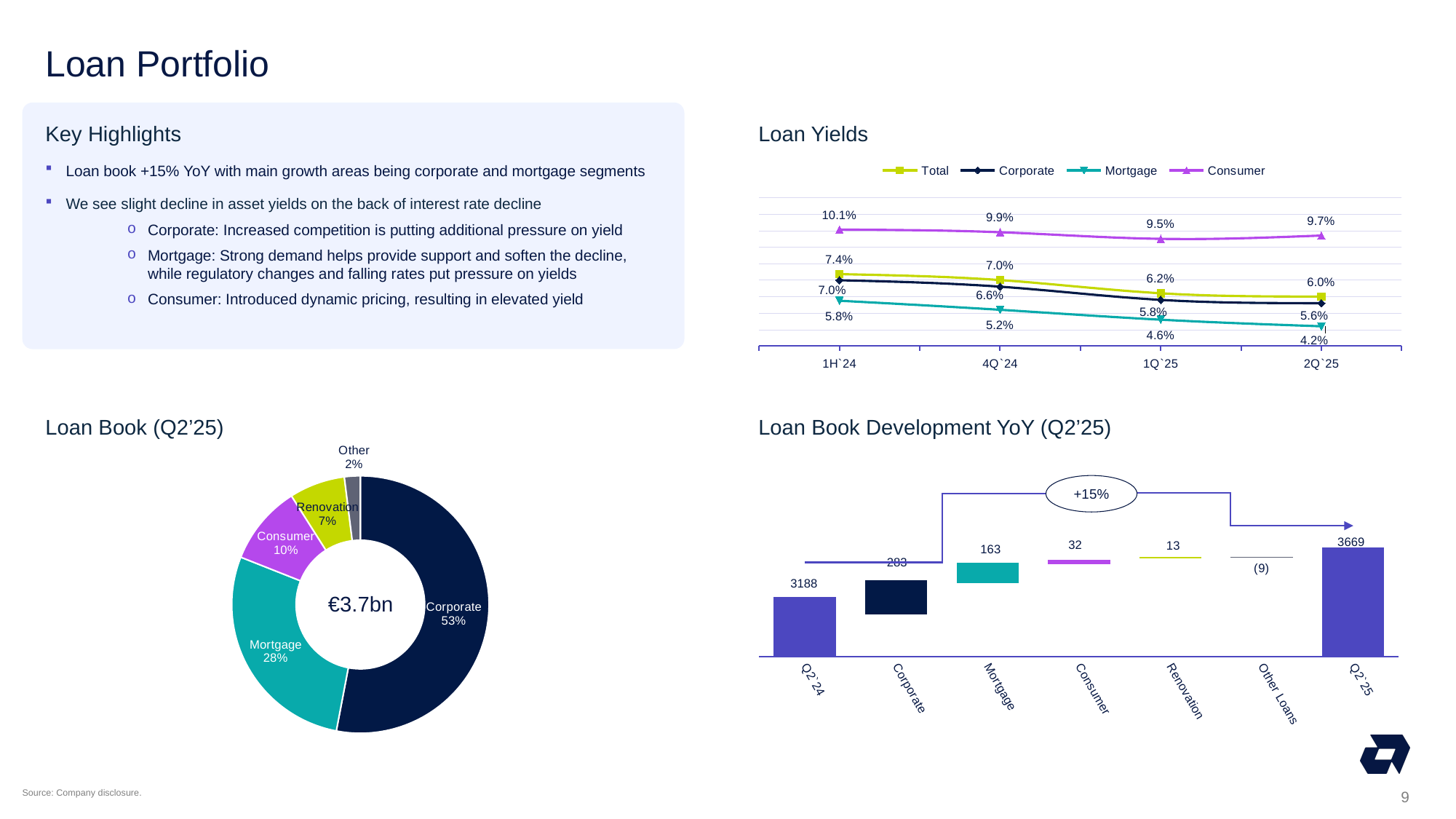
In the Loan Yields chart, how many series does the legend list? 4 In the Loan Yields chart, what is the Consumer yield in 1H`24? 10.1% In the Loan Book (Q2'25) chart, which segment has the smallest share? Other In the Loan Yields chart, which series has the highest yield in 2Q`25? Consumer In the Loan Book Development YoY (Q2'25) chart, what is the value for Q2`25? 3669 What kind of chart is the Loan Book Development YoY (Q2'25) chart? Bar chart (waterfall) In the Loan Yields chart, does the Mortgage yield rise or fall from 1H`24 to 2Q`25? Fall In the Loan Yields chart, what is the Mortgage yield in 2Q`25? 4.2% In the Loan Book Development YoY (Q2'25) chart, which is larger, the Mortgage contribution or the Consumer contribution? Mortgage In the Loan Book (Q2'25) chart, what share does Mortgage represent? 28% In the Loan Book (Q2'25) chart, how many segments are shown? 5 In the Loan Yields chart, what is the difference between the Total yield in 1H`24 and in 2Q`25? 1.4%